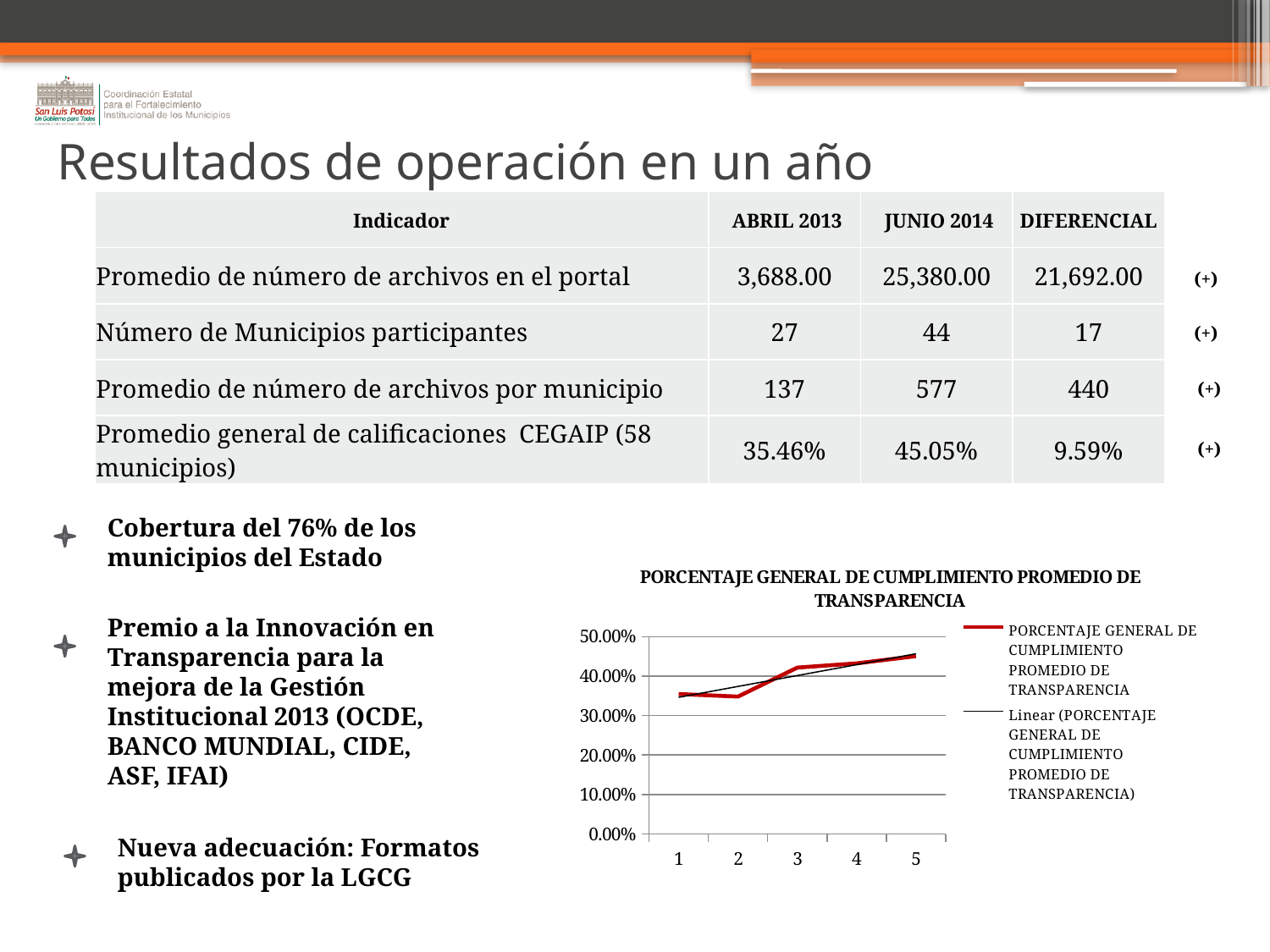
Is the value at point 2 greater or less than 40.00%? less Do the values in the chart generally rise or fall from point 1 to point 5? rise What kind of chart is shown on the slide? line chart What colour is the line for PORCENTAJE GENERAL DE CUMPLIMIENTO PROMEDIO DE TRANSPARENCIA in the chart? red Which is larger, the value at point 3 or the value at point 1? point 3 Which point has the highest value in the chart? 5 How many points are plotted along the x axis of the chart? 5 Is the value at point 3 greater or less than 40.00%? greater Is the value at point 1 greater or less than 40.00%? less What is the title of the chart on the slide? PORCENTAJE GENERAL DE CUMPLIMIENTO PROMEDIO DE TRANSPARENCIA How many entries does the chart's legend list? 2